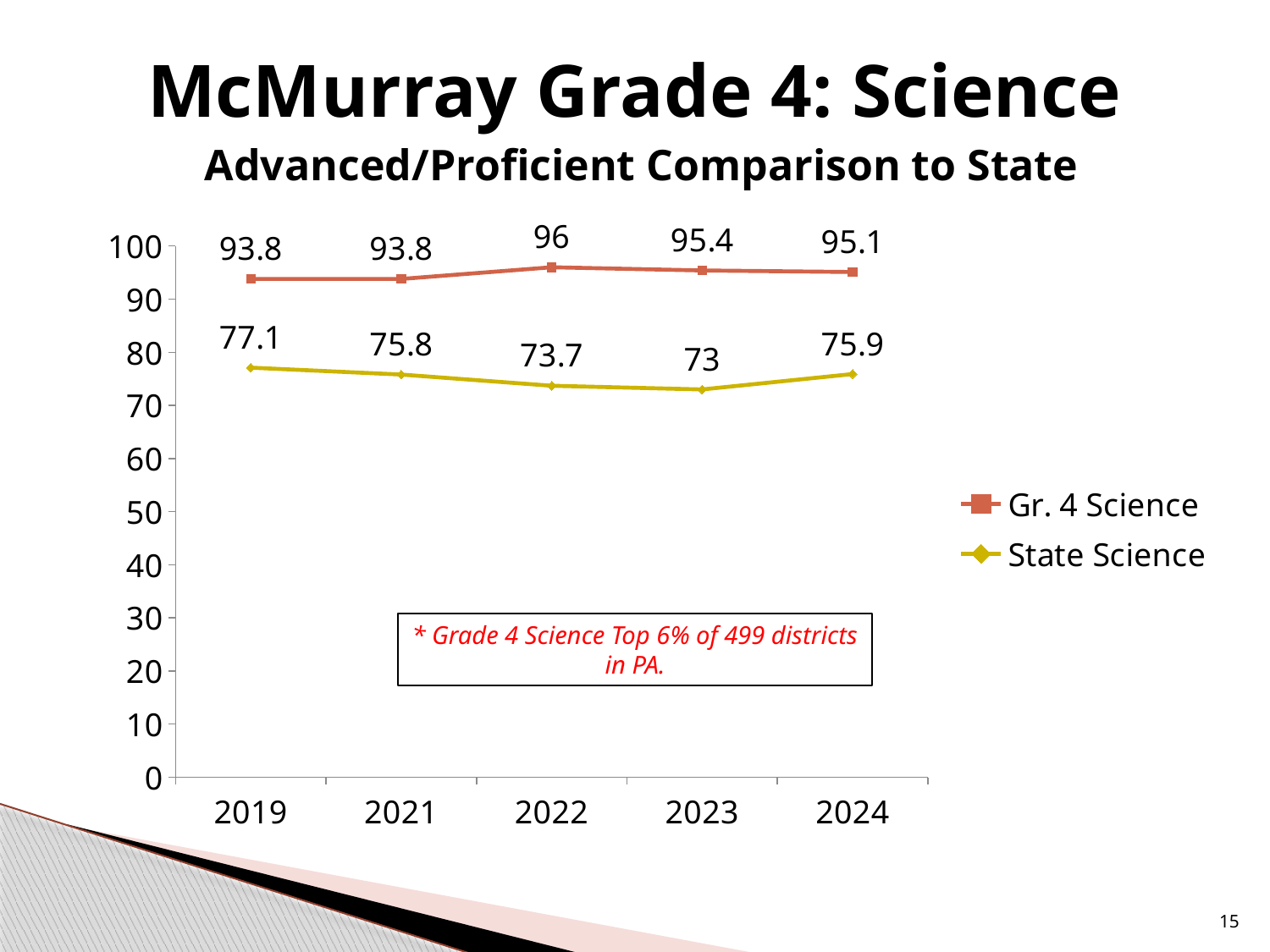
In which year is the Gr. 4 Science value highest? 2022 How many years are shown on the x axis? 5 What kind of chart is shown on the slide? Line chart How many series does the legend list? 2 What is the difference between Gr. 4 Science and State Science in 2024? 19.2 What is the State Science value for 2023? 73 Which is larger in 2019: Gr. 4 Science or State Science? Gr. 4 Science What is the Gr. 4 Science value for 2024? 95.1 What is the Gr. 4 Science value for 2022? 96 Does the State Science value rise or fall from 2019 to 2023? Fall In which year is the State Science value highest? 2019 In which year is the State Science value lowest? 2023